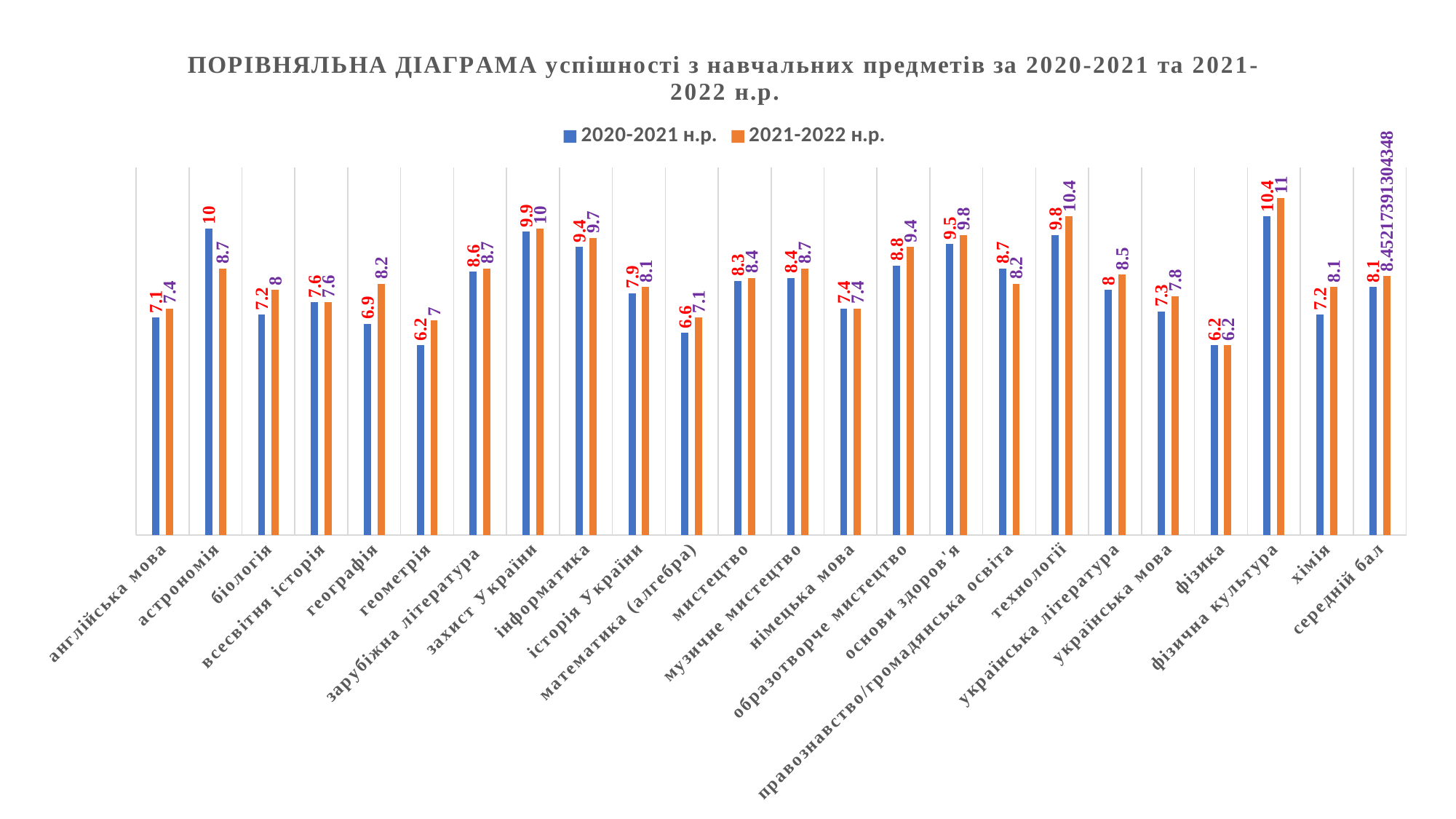
What is the value for геометрія in the 2020-2021 н.р. series? 6.2 What is the value for астрономія in the 2020-2021 н.р. series? 10 What is the value for географія in the 2021-2022 н.р. series? 8.2 What is the value for фізична культура in the 2021-2022 н.р. series? 11 What is the difference between the 2020-2021 н.р. and 2021-2022 н.р. values for астрономія? 1.3 How many series does the legend list? 2 What is the difference between the 2021-2022 н.р. and 2020-2021 н.р. values for географія? 1.3 Which category has the highest value in the 2021-2022 н.р. series? фізична культура For правознавство/громадянська освіта, which series has the larger value: 2020-2021 н.р. or 2021-2022 н.р.? 2020-2021 н.р. Which category has the lowest value in the 2021-2022 н.р. series? фізика What kind of chart is shown on the slide? bar chart How many categories are shown on the x axis? 24